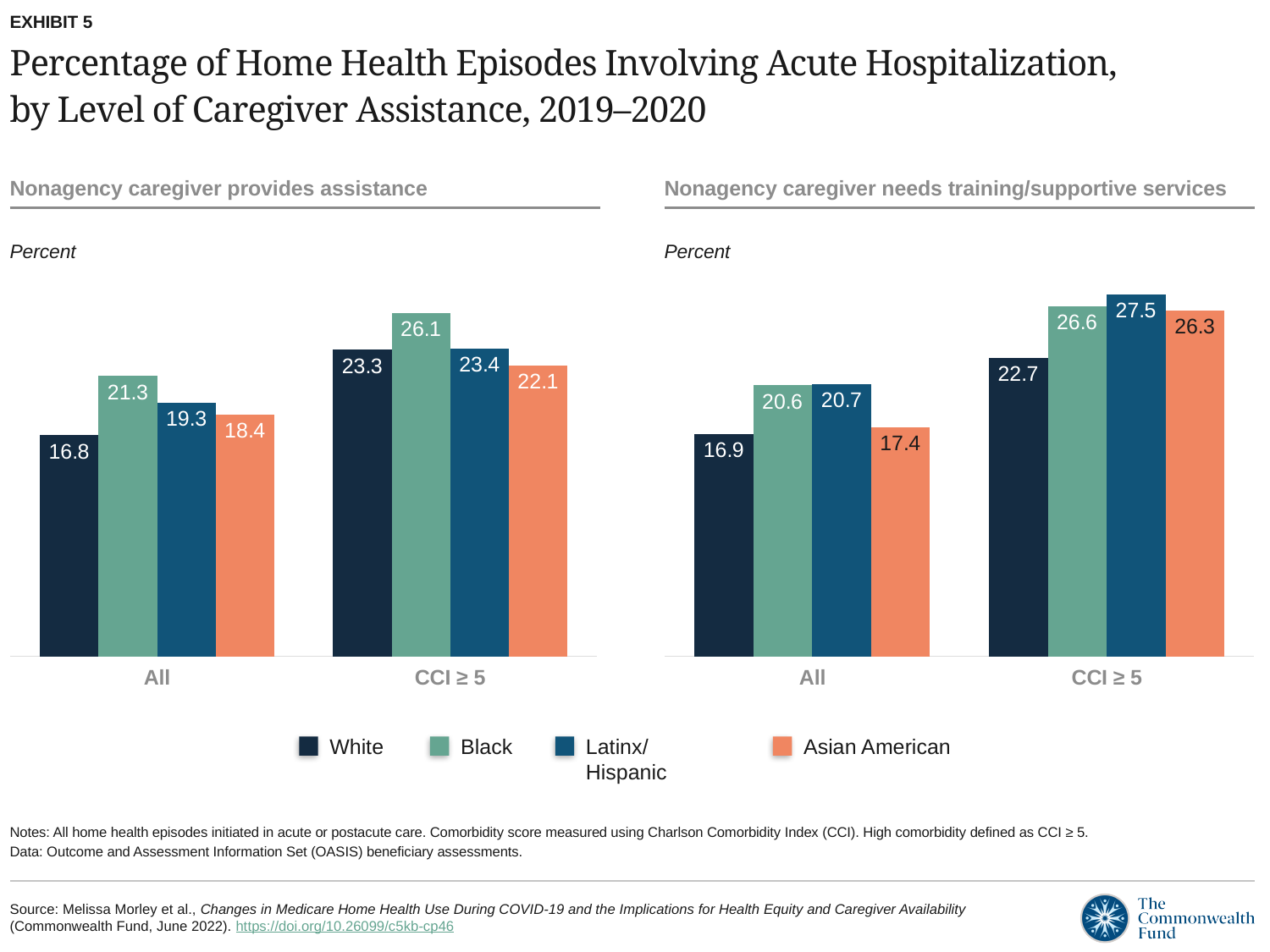
In the 'Nonagency caregiver provides assistance' chart, what is the difference between the Black and White values in the All group? 4.5 In the 'Nonagency caregiver provides assistance' chart, which group has the highest value in the CCI ≥ 5 category? Black How many categories are shown on the x axis of the 'Nonagency caregiver provides assistance' chart? 2 In the 'Nonagency caregiver needs training/supportive services' chart, what is the difference between the Latinx/Hispanic and Asian American values in the CCI ≥ 5 group? 1.2 In the 'Nonagency caregiver needs training/supportive services' chart, which is larger in the CCI ≥ 5 group: White or Black? Black In the 'Nonagency caregiver provides assistance' chart, what is the value for Black in the All group? 21.3 In the 'Nonagency caregiver needs training/supportive services' chart, what is the value for Latinx/Hispanic in the CCI ≥ 5 group? 27.5 In the 'Nonagency caregiver needs training/supportive services' chart, what is the value for Asian American in the All group? 17.4 What kind of chart is the 'Nonagency caregiver needs training/supportive services' chart? Bar chart In the 'Nonagency caregiver needs training/supportive services' chart, which group has the lowest value in the All category? White How many series does the legend list? 4 In the 'Nonagency caregiver provides assistance' chart, which is larger in the All group: Latinx/Hispanic or Asian American? Latinx/Hispanic